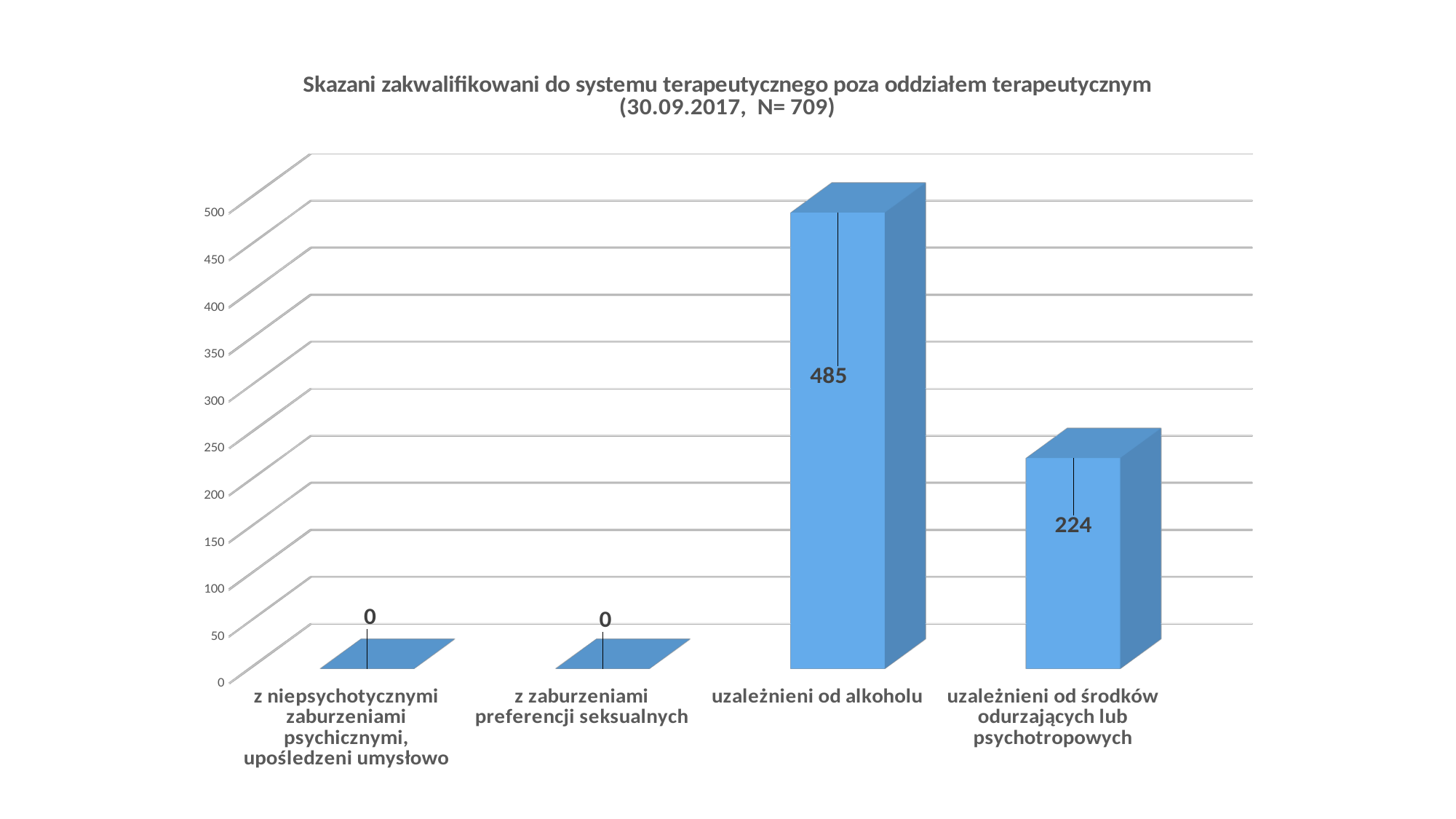
What is the difference between the values for "uzależnieni od alkoholu" and "uzależnieni od środków odurzających lub psychotropowych"? 261 Which is larger: the value for "uzależnieni od alkoholu" or for "uzależnieni od środków odurzających lub psychotropowych"? uzależnieni od alkoholu What is the value for "z niepsychotycznymi zaburzeniami psychicznymi, upośledzeni umysłowo"? 0 Which category has the highest value? uzależnieni od alkoholu What is the value for "uzależnieni od środków odurzających lub psychotropowych"? 224 How many categories are shown on the x axis? 4 What is the N value given in the chart title? 709 What is the value for "z zaburzeniami preferencji seksualnych"? 0 What is the value for "uzależnieni od alkoholu"? 485 Is the value for "uzależnieni od alkoholu" greater or less than 400? greater What kind of chart is shown on the slide? bar chart Is the value for "uzależnieni od środków odurzających lub psychotropowych" greater or less than 250? less